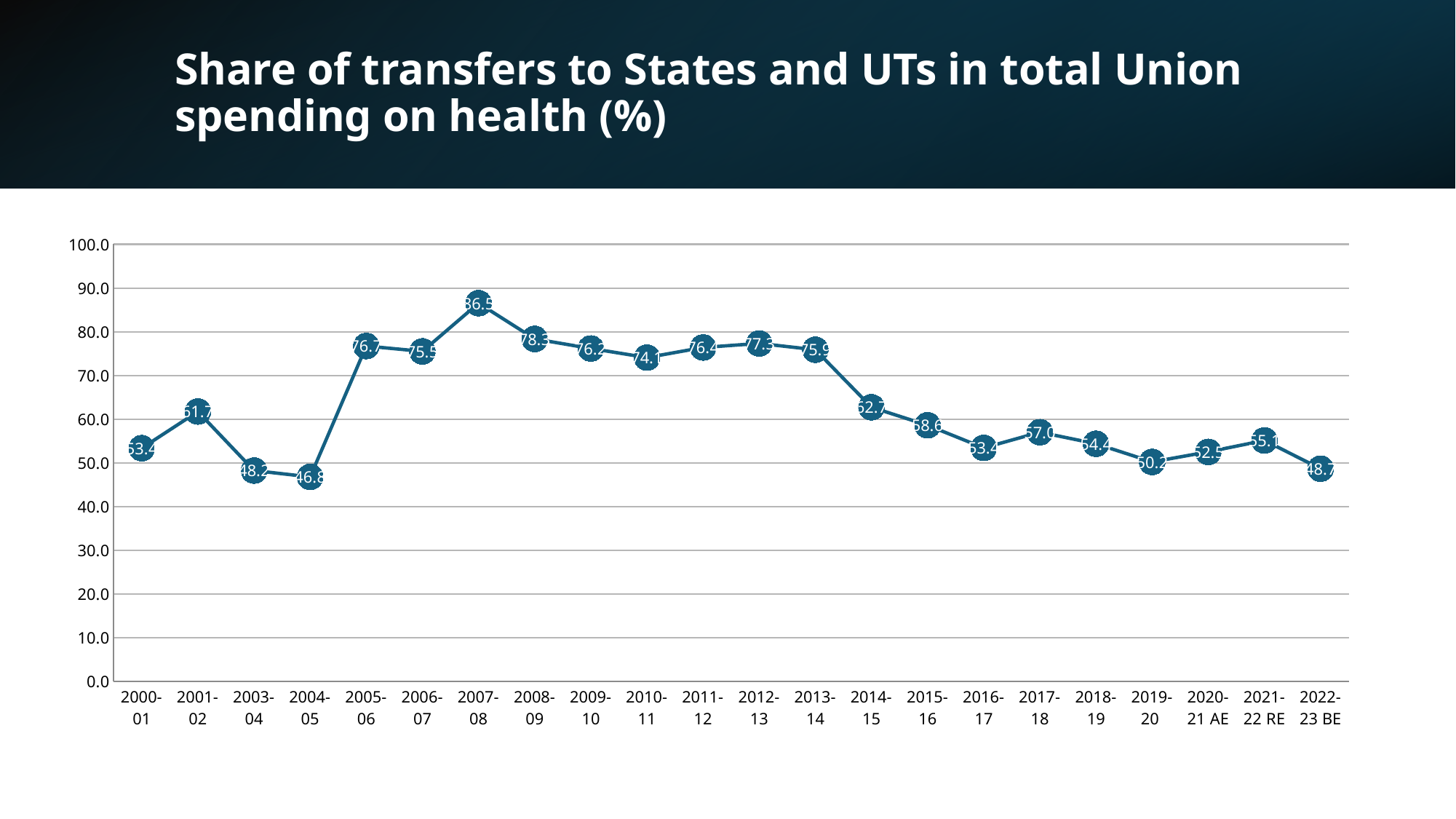
How many years are plotted on the x axis? 22 What is the value for 2017-18? 57.0 What is the share of transfers to States and UTs in 2007-08? 86.5 Which is larger, the value for 2005-06 or the value for 2006-07? 2005-06 What is the value for 2022-23 BE? 48.7 What is the difference between the values for 2007-08 and 2008-09? 8.2 Is the value for 2014-15 greater or less than 60? greater Do the values rise or fall from 2013-14 to 2016-17? fall What is the difference between the values for 2013-14 and 2014-15? 13.2 Which year has the highest share of transfers to States and UTs? 2007-08 What kind of chart is shown on the slide? line chart Which year has the lowest share of transfers to States and UTs? 2004-05